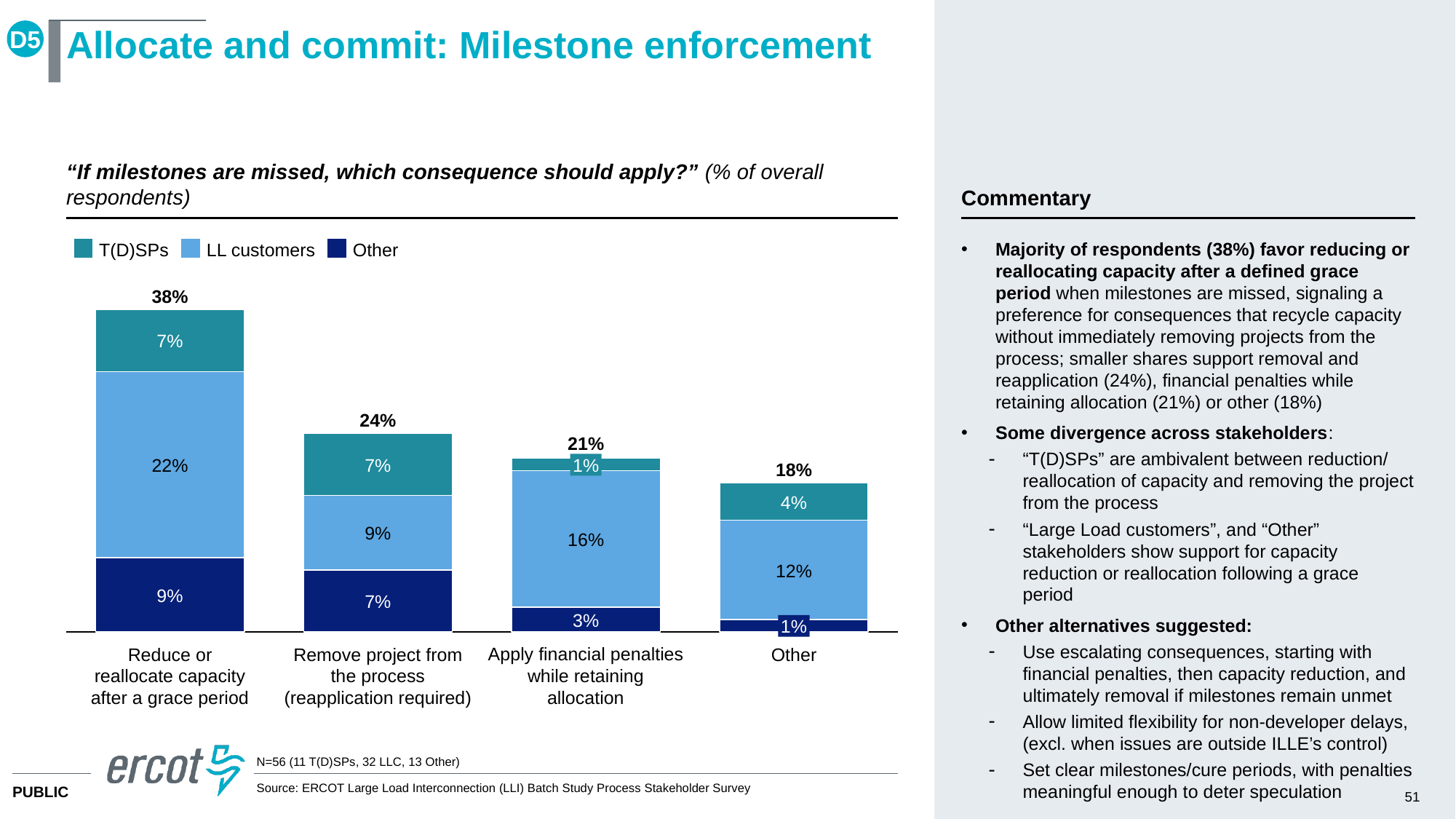
How many series does the legend list? 3 Which consequence category has the lowest total percentage? Other How many consequence categories are shown on the x axis? 4 Which is larger: the LL customers value for 'Reduce or reallocate capacity after a grace period' or the LL customers value for 'Other'? Reduce or reallocate capacity after a grace period What is the LL customers value for 'Apply financial penalties while retaining allocation'? 16% What is the difference between the total for 'Reduce or reallocate capacity after a grace period' and the total for 'Remove project from the process (reapplication required)'? 14% Which consequence category has the highest total percentage? Reduce or reallocate capacity after a grace period What is the T(D)SPs value for the 'Other' category? 4% What type of chart is shown on the slide? Stacked bar chart Which series is shown in the darkest blue colour in the legend? Other What is the 'Other' stakeholder value for 'Remove project from the process (reapplication required)'? 7% What is the total percentage of respondents for 'Reduce or reallocate capacity after a grace period'? 38%